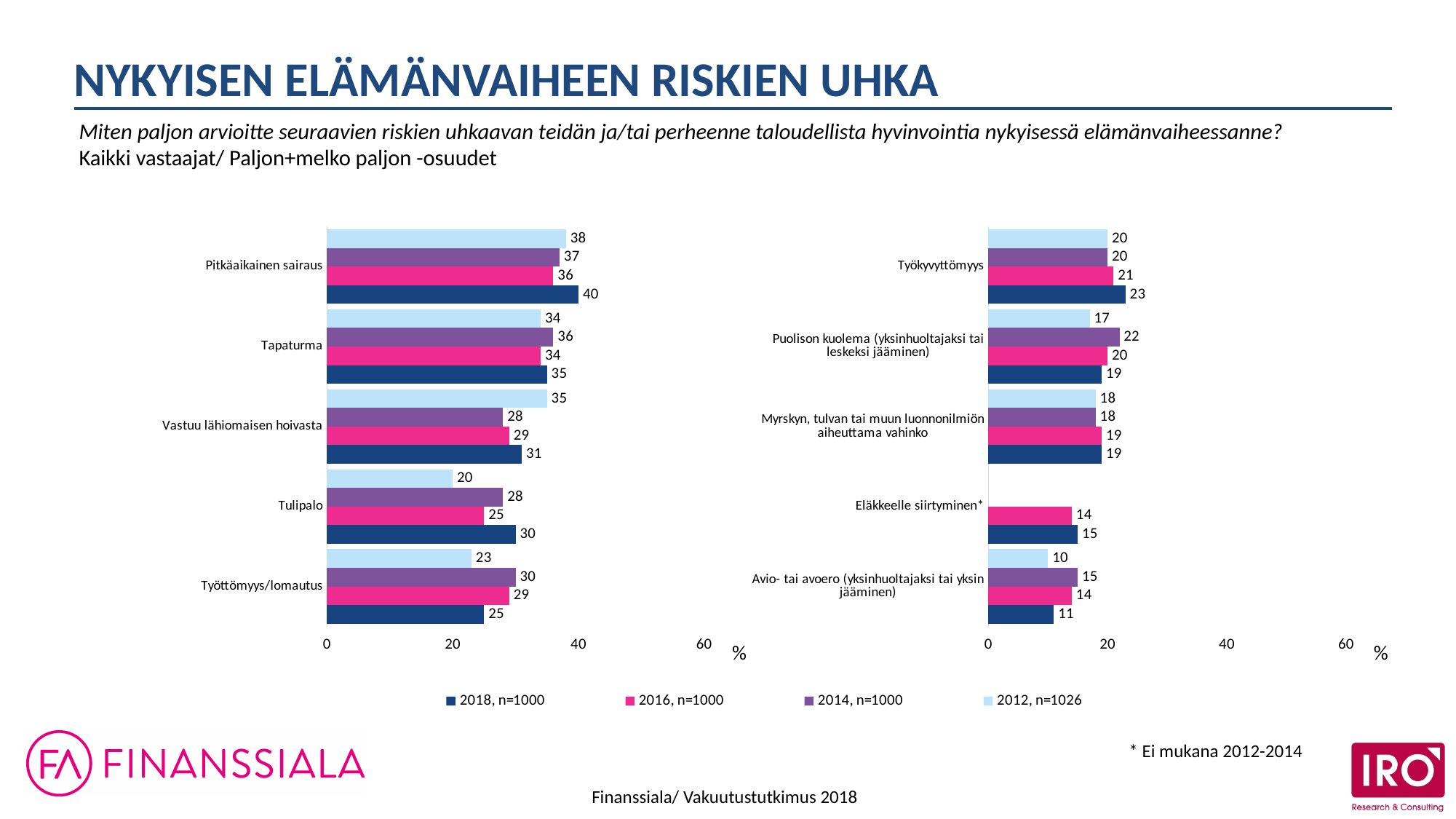
What kind of chart is the left chart? Bar chart In the left chart, which category has the highest 2018 value? Pitkäaikainen sairaus In the right chart, which category has the lowest 2012 value? Avio- tai avoero (yksinhuoltajaksi tai yksin jääminen) In the right chart, what is the 2014 value for Puolison kuolema (yksinhuoltajaksi tai leskeksi jääminen)? 22 In the left chart, what is the 2018 value for Pitkäaikainen sairaus? 40 In the right chart, which category has no bars for 2012 and 2014? Eläkkeelle siirtyminen* In the right chart, what is the 2018 value for Avio- tai avoero (yksinhuoltajaksi tai yksin jääminen)? 11 How many categories are shown in the right chart? 5 How many series does the legend list? 4 In the left chart, what is the 2012 value for Tulipalo? 20 In the left chart, what is the difference between the 2018 and 2012 values for Työttömyys/lomautus? 2 In the left chart, which is larger for Tulipalo: the 2018 value or the 2016 value? 2018